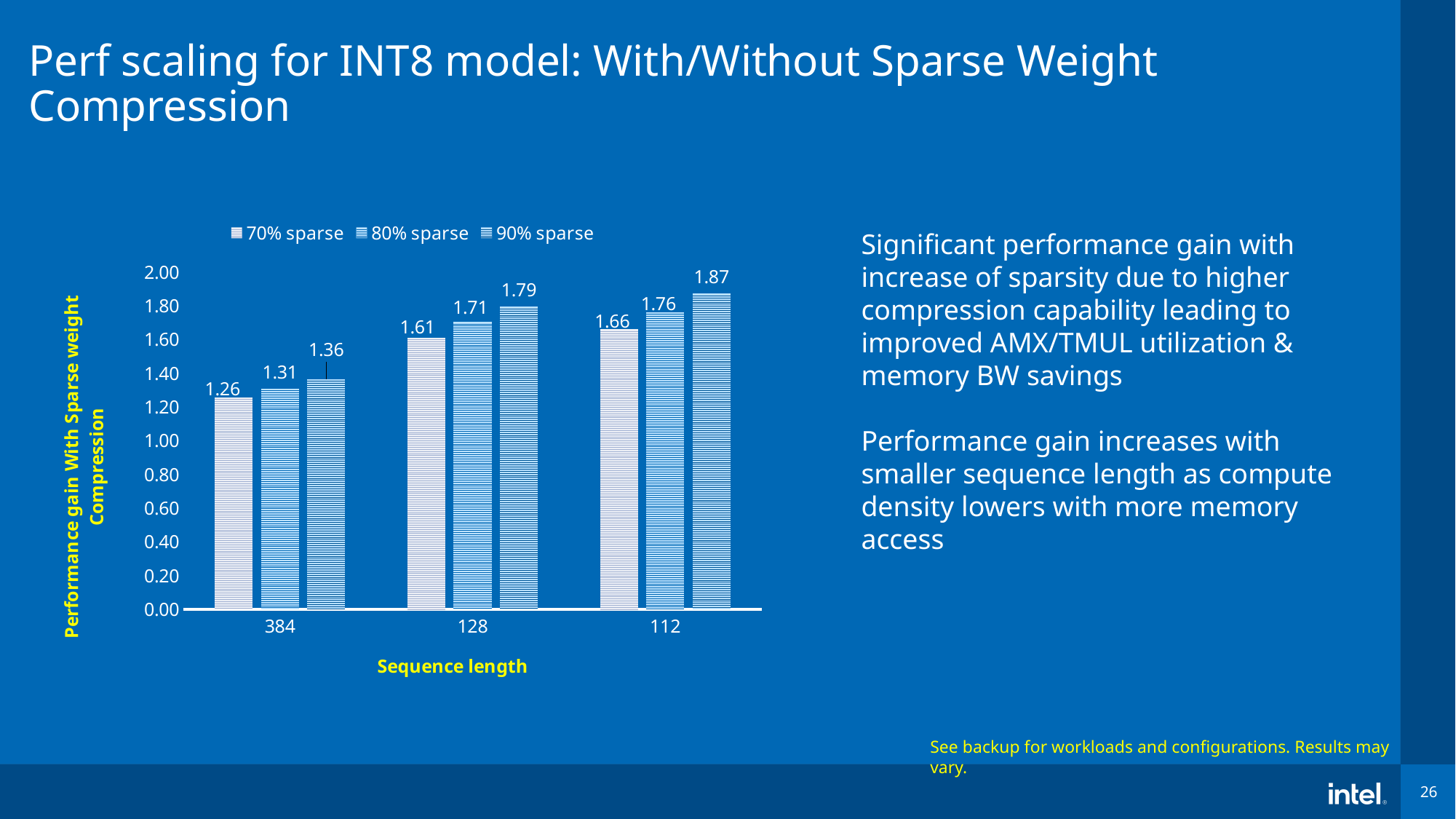
What is the performance gain for 90% sparse at sequence length 112? 1.87 Is the 90% sparse value at sequence length 128 greater or less than 1.60? greater What is the performance gain for 70% sparse at sequence length 384? 1.26 What is the difference between the 90% sparse and 70% sparse performance gain at sequence length 384? 0.10 Which sequence length has the lowest performance gain for 70% sparse? 384 Which sequence length has the highest performance gain for 90% sparse? 112 How many series does the legend list? 3 What kind of chart is shown on the slide? Bar chart How many sequence length categories are shown on the x axis? 3 Which is larger: the 80% sparse gain at sequence length 128 or the 70% sparse gain at sequence length 112? 80% sparse at 128 What is the label of the x axis? Sequence length What is the performance gain for 80% sparse at sequence length 128? 1.71